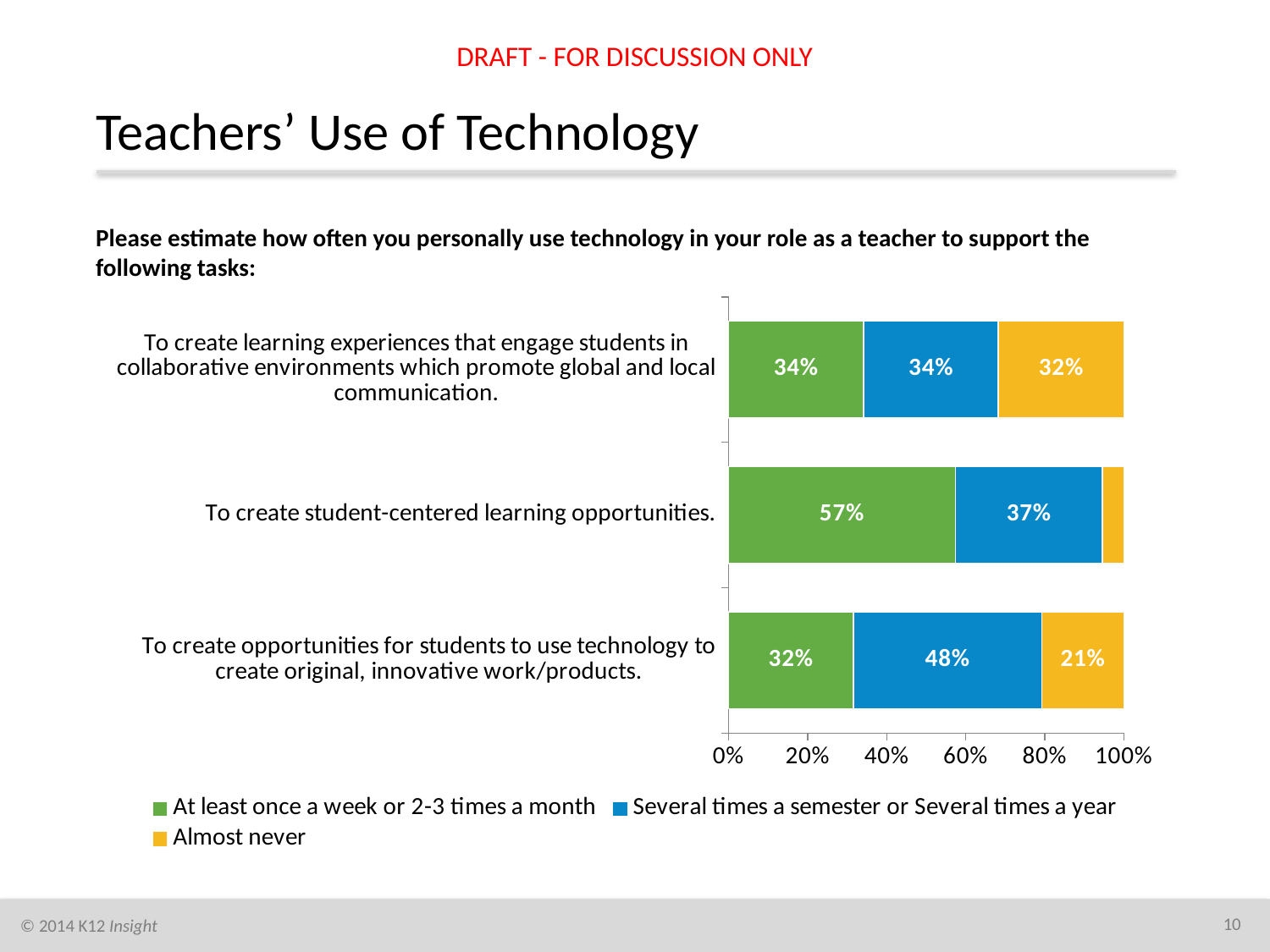
How many response categories does the legend list? 3 Which task has a larger 'Several times a semester or Several times a year' share: creating collaborative learning experiences or creating opportunities for students to create original, innovative work/products? To create opportunities for students to use technology to create original, innovative work/products. What percentage of teachers use technology at least once a week or 2-3 times a month to create student-centered learning opportunities? 57% How many tasks are shown in the chart? 3 What kind of chart is shown on the slide? Stacked bar chart What is the total of the stacked bar for creating learning experiences that engage students in collaborative environments? 100% What percentage of teachers use technology several times a semester or several times a year to create opportunities for students to use technology to create original, innovative work/products? 48% Which task has the highest share of teachers using technology at least once a week or 2-3 times a month? To create student-centered learning opportunities. For creating student-centered learning opportunities, what is the difference in percentage points between the 'At least once a week or 2-3 times a month' share and the 'Several times a semester or Several times a year' share? 20 percentage points Which task has the smallest 'Almost never' share? To create student-centered learning opportunities. Is the 'At least once a week or 2-3 times a month' share for creating student-centered learning opportunities greater or less than 40%? greater What percentage of teachers almost never use technology to create learning experiences that engage students in collaborative environments which promote global and local communication? 32%